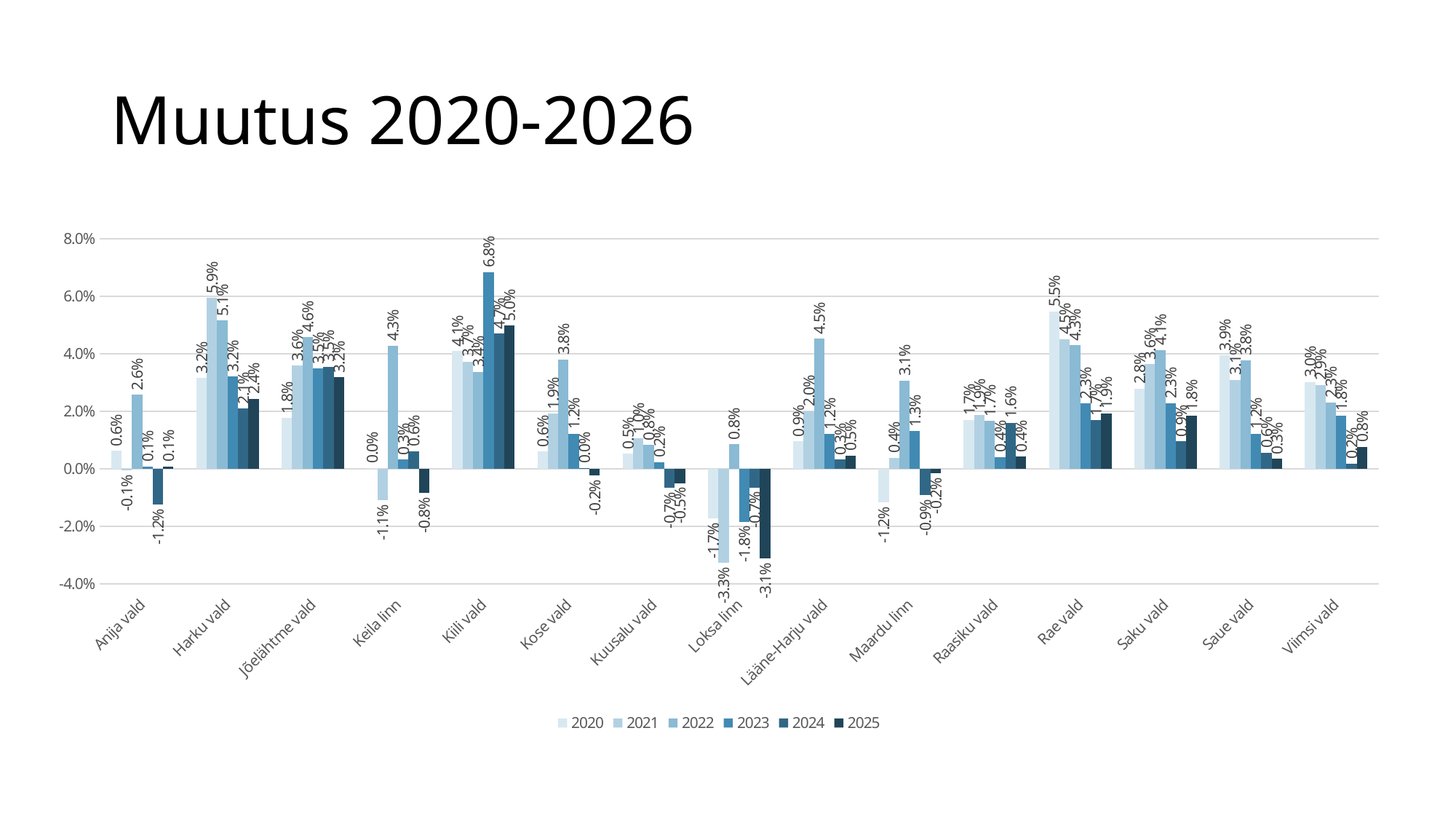
How many categories are shown on the x axis? 15 What is the value for Harku vald in the 2021 series? 5.9% How many series does the legend list? 6 What is the title of the slide? Muutus 2020-2026 What is the difference between the 2021 and 2020 values for Harku vald? 2.7 percentage points Which category has the highest value in the 2023 series? Kiili vald Which is larger: the 2020 value for Rae vald or the 2021 value for Harku vald? The 2021 value for Harku vald Which category has the lowest value in the 2021 series? Loksa linn What is the value for Kiili vald in the 2023 series? 6.8% What is the value for Rae vald in the 2020 series? 5.5% What is the value for Loksa linn in the 2021 series? -3.3% What kind of chart is shown on the slide? Bar chart